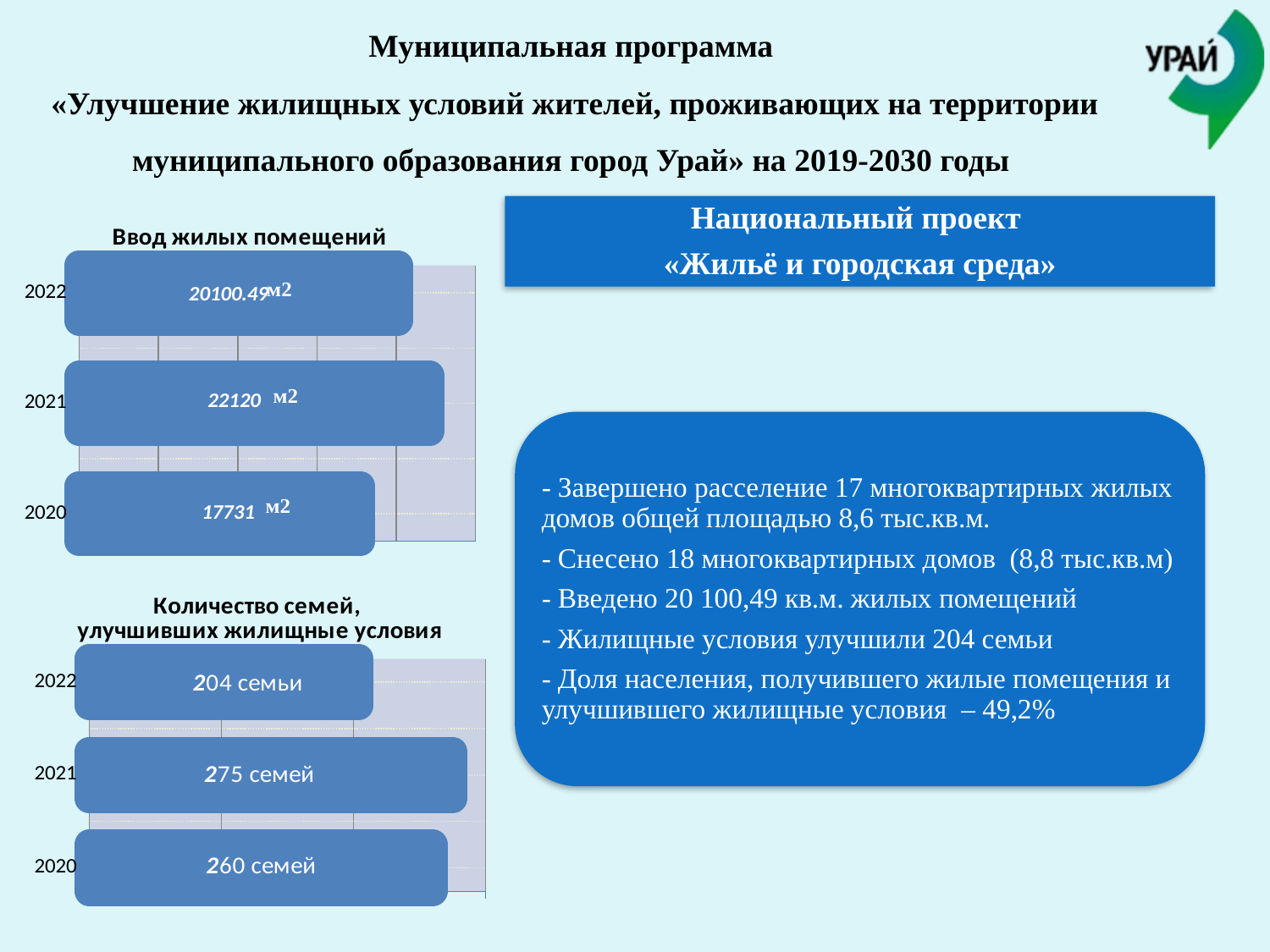
In the chart 'Количество семей, улучшивших жилищные условия', which is larger: the value for 2020 or the value for 2022? 2020 In the chart 'Ввод жилых помещений', which year has the lowest value? 2020 What kind of chart is 'Количество семей, улучшивших жилищные условия'? Bar chart In the chart 'Количество семей, улучшивших жилищные условия', what is the difference between the values for 2021 and 2022? 71 In the chart 'Ввод жилых помещений', how many years are shown? 3 In the chart 'Ввод жилых помещений', which year has the highest value? 2021 In the chart 'Количество семей, улучшивших жилищные условия', what is the value for 2022? 204 семьи In the chart 'Ввод жилых помещений', what is the value for 2020? 17731 м2 In the chart 'Количество семей, улучшивших жилищные условия', which year has the lowest value? 2022 In the chart 'Ввод жилых помещений', what is the value for 2022? 20100.49 м2 In the chart 'Количество семей, улучшивших жилищные условия', what is the value for 2021? 275 семей In the chart 'Ввод жилых помещений', what is the difference between the values for 2021 and 2020? 4389 м2